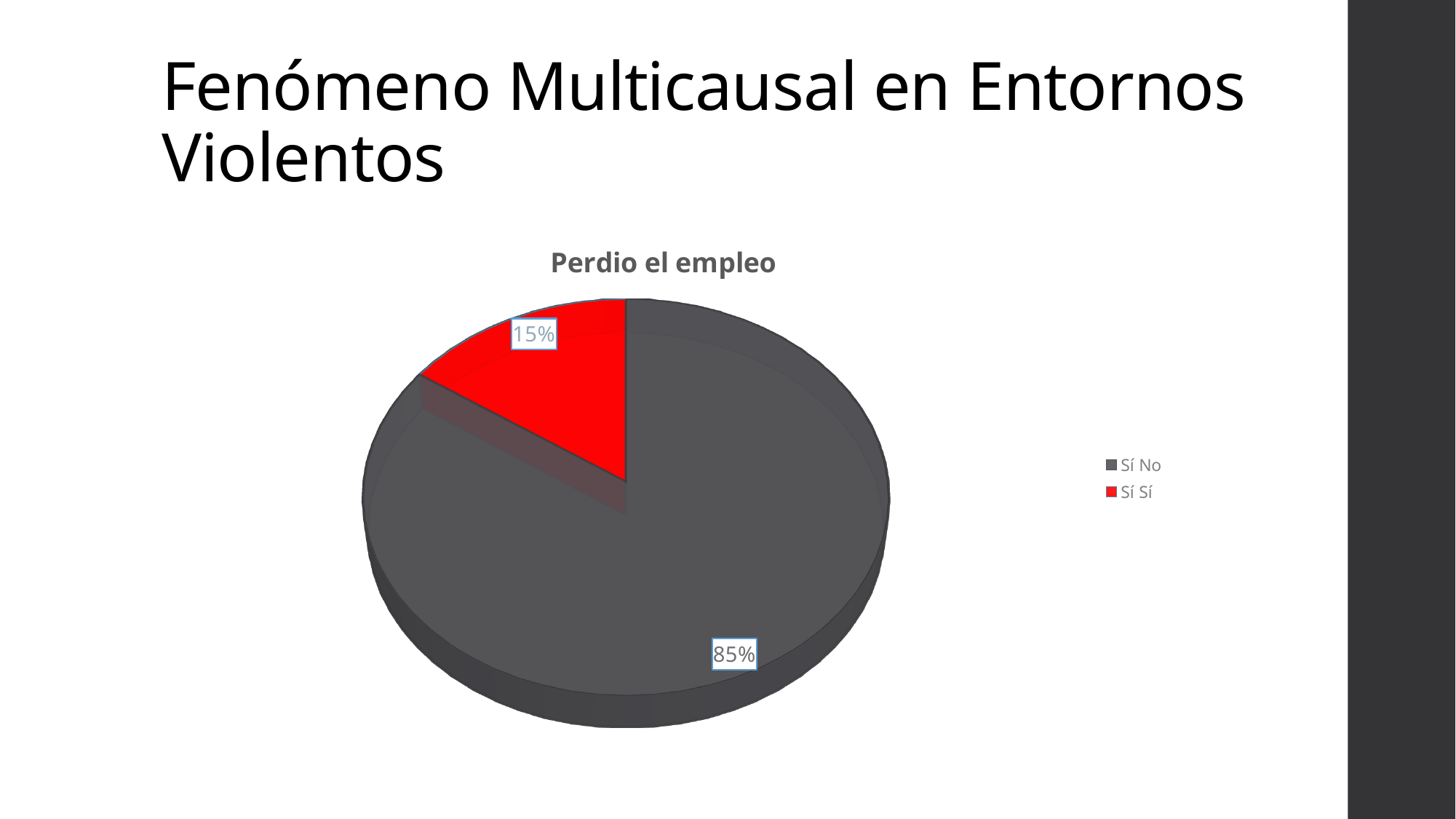
How many slices does the pie chart have? 2 What type of chart is shown on the slide? Pie chart Which is larger, the 'Sí No' slice or the 'Sí Sí' slice? Sí No What is the title of the chart? Perdio el empleo What percentage is shown for the 'Sí No' slice? 85% Which slice is the smallest? Sí Sí What is the difference in percentage points between the 'Sí No' and 'Sí Sí' slices? 70 What share of the pie does the 'Sí Sí' slice represent? 15% Which slice is the largest? Sí No How many entries does the legend list? 2 What percentage is shown for the 'Sí Sí' slice? 15% What colour is the 'Sí Sí' slice? Red